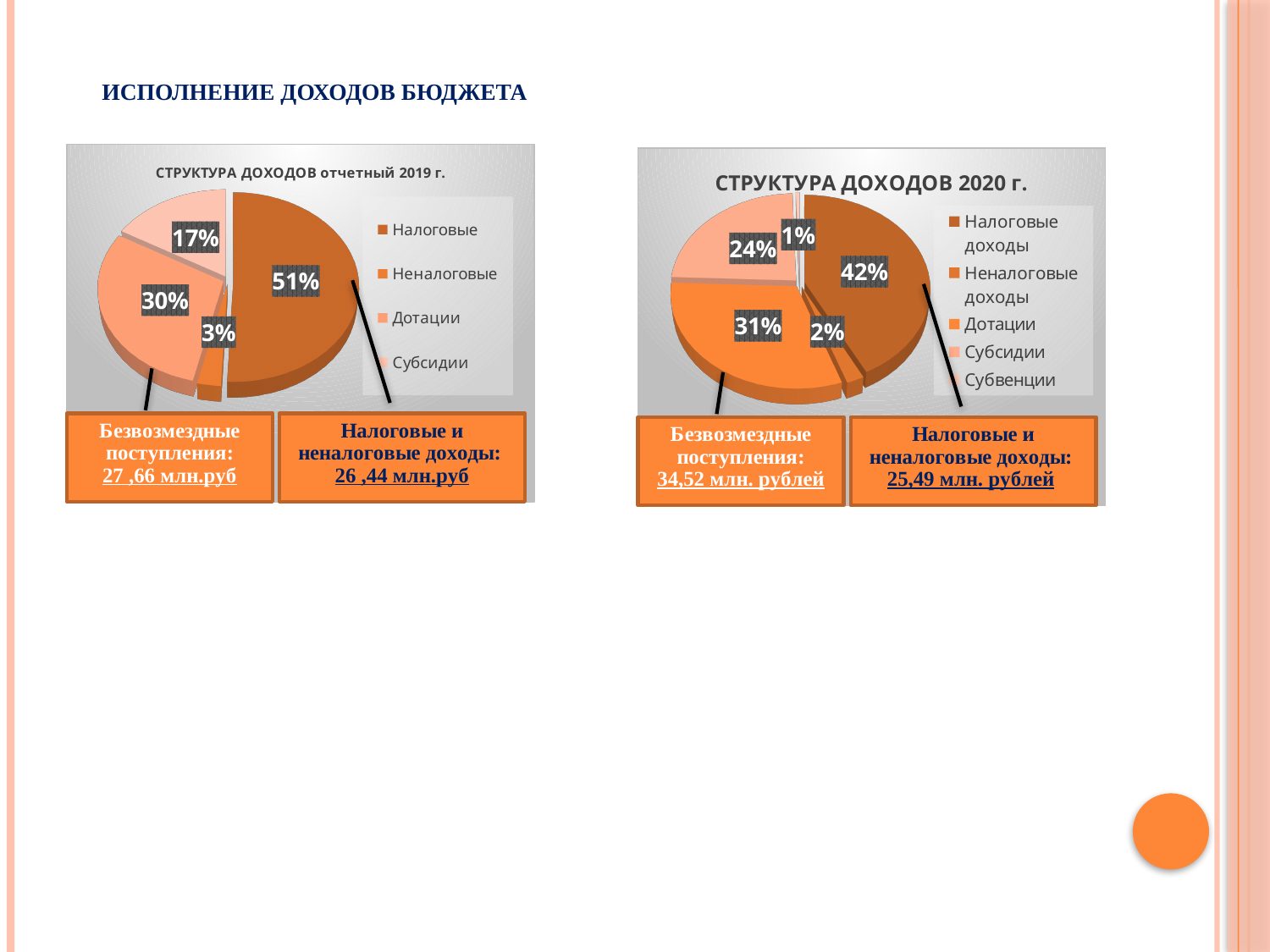
In the 'СТРУКТУРА ДОХОДОВ отчетный 2019 г.' chart, what share do Налоговые revenues have? 51% In the 'СТРУКТУРА ДОХОДОВ отчетный 2019 г.' chart, what is the difference between the shares of Дотации and Субсидии? 13% In the 'СТРУКТУРА ДОХОДОВ 2020 г.' chart, which is larger: Дотации or Субсидии? Дотации How many categories does the legend of the 'СТРУКТУРА ДОХОДОВ 2020 г.' chart list? 5 In the 'СТРУКТУРА ДОХОДОВ отчетный 2019 г.' chart, which category has the smallest share? Неналоговые In the 'СТРУКТУРА ДОХОДОВ 2020 г.' chart, what share do Субсидии have? 24% In the 'СТРУКТУРА ДОХОДОВ отчетный 2019 г.' chart, what share do Дотации have? 30% What type of chart is used in the 'СТРУКТУРА ДОХОДОВ отчетный 2019 г.' chart? pie chart In the 'СТРУКТУРА ДОХОДОВ 2020 г.' chart, which category has the largest share? Налоговые доходы How many categories does the legend of the 'СТРУКТУРА ДОХОДОВ отчетный 2019 г.' chart list? 4